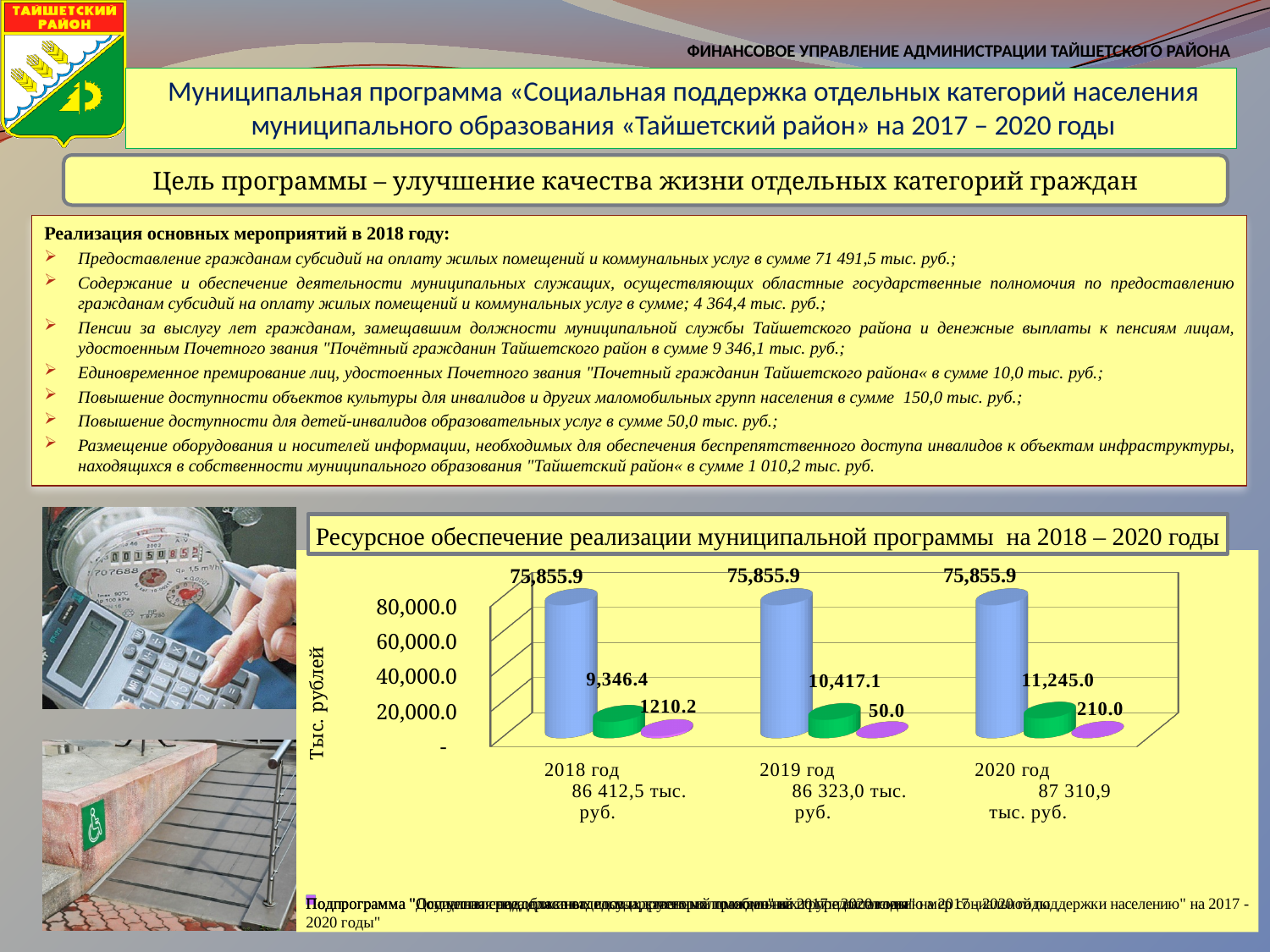
For 2019 год, which is larger: the green bar or the purple bar? the green bar What is the value of the blue bar for 2018 год? 75,855.9 In which year is the purple bar the lowest? 2019 год Is the value of the blue bar for 2019 год greater or less than 60,000.0? greater How many year categories are shown on the x axis of the chart? 3 What is the value of the green bar for 2019 год? 10,417.1 What kind of chart is shown under the heading «Ресурсное обеспечение реализации муниципальной программы на 2018 – 2020 годы»? bar chart What is the difference between the green bar values for 2020 год and 2018 год? 1,898.6 Do the green bar values rise or fall from 2018 год to 2020 год? rise What is the label on the vertical axis of the chart? Тыс. рублей What is the value of the purple bar for 2020 год? 210.0 In which year is the green bar the highest? 2020 год